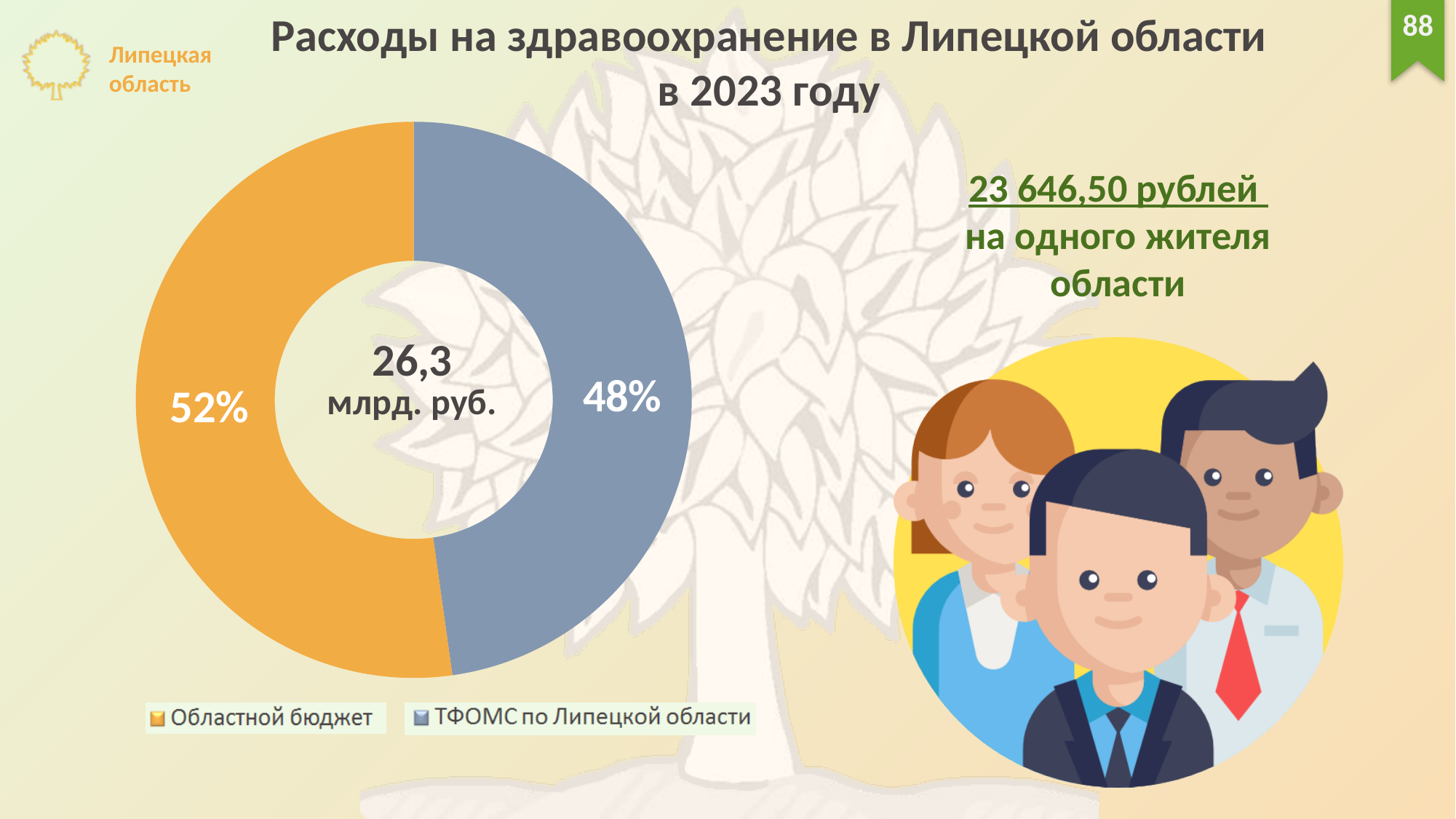
What total amount is shown in the centre of the chart? 26,3 млрд. руб. Which category has the largest share in the chart? Областной бюджет What share of healthcare spending comes from Областной бюджет? 52% What is the difference in percentage points between the Областной бюджет share and the ТФОМС по Липецкой области share? 4 percentage points What is the title of the slide containing the chart? Расходы на здравоохранение в Липецкой области в 2023 году Which source has the larger share: Областной бюджет or ТФОМС по Липецкой области? Областной бюджет What kind of chart is shown on the slide? Doughnut (pie) chart What colour represents Областной бюджет in the chart? Orange How many entries does the legend list? 2 How many categories does the chart show? 2 Which category has the smallest share in the chart? ТФОМС по Липецкой области What share of healthcare spending comes from ТФОМС по Липецкой области? 48%